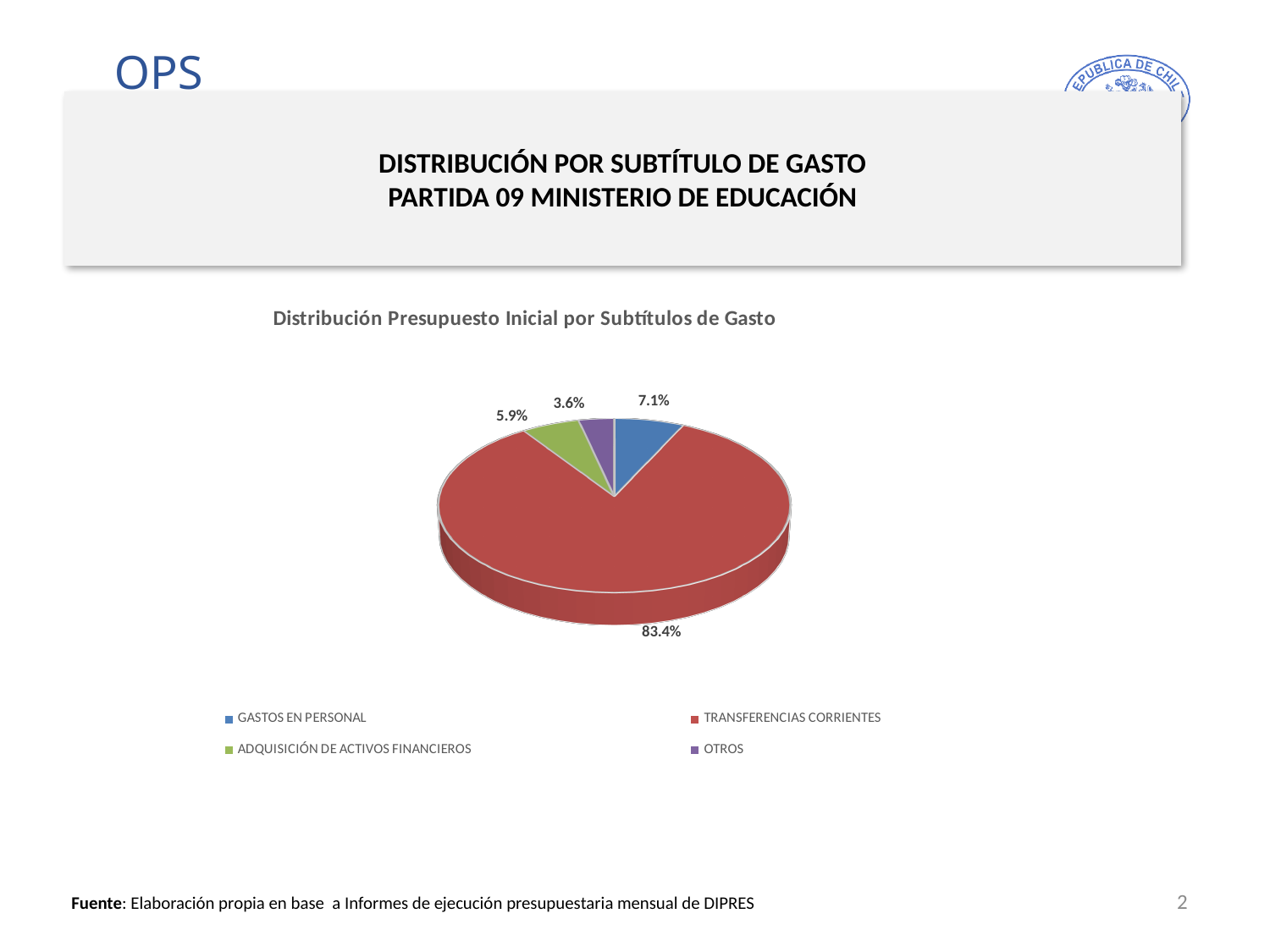
What share of the pie does GASTOS EN PERSONAL represent? 7.1% What share of the pie does ADQUISICIÓN DE ACTIVOS FINANCIEROS represent? 5.9% What share of the pie does OTROS represent? 3.6% Which colour represents TRANSFERENCIAS CORRIENTES in the pie chart? Red Which category has the smallest slice of the pie? OTROS What kind of chart is shown on the slide? Pie chart What is the difference in percentage points between the shares of GASTOS EN PERSONAL and OTROS? 3.5 Which category has the largest slice of the pie? TRANSFERENCIAS CORRIENTES What is the title of the chart? Distribución Presupuesto Inicial por Subtítulos de Gasto How many categories does the pie chart show? 4 Which is larger, the share for GASTOS EN PERSONAL or the share for ADQUISICIÓN DE ACTIVOS FINANCIEROS? GASTOS EN PERSONAL